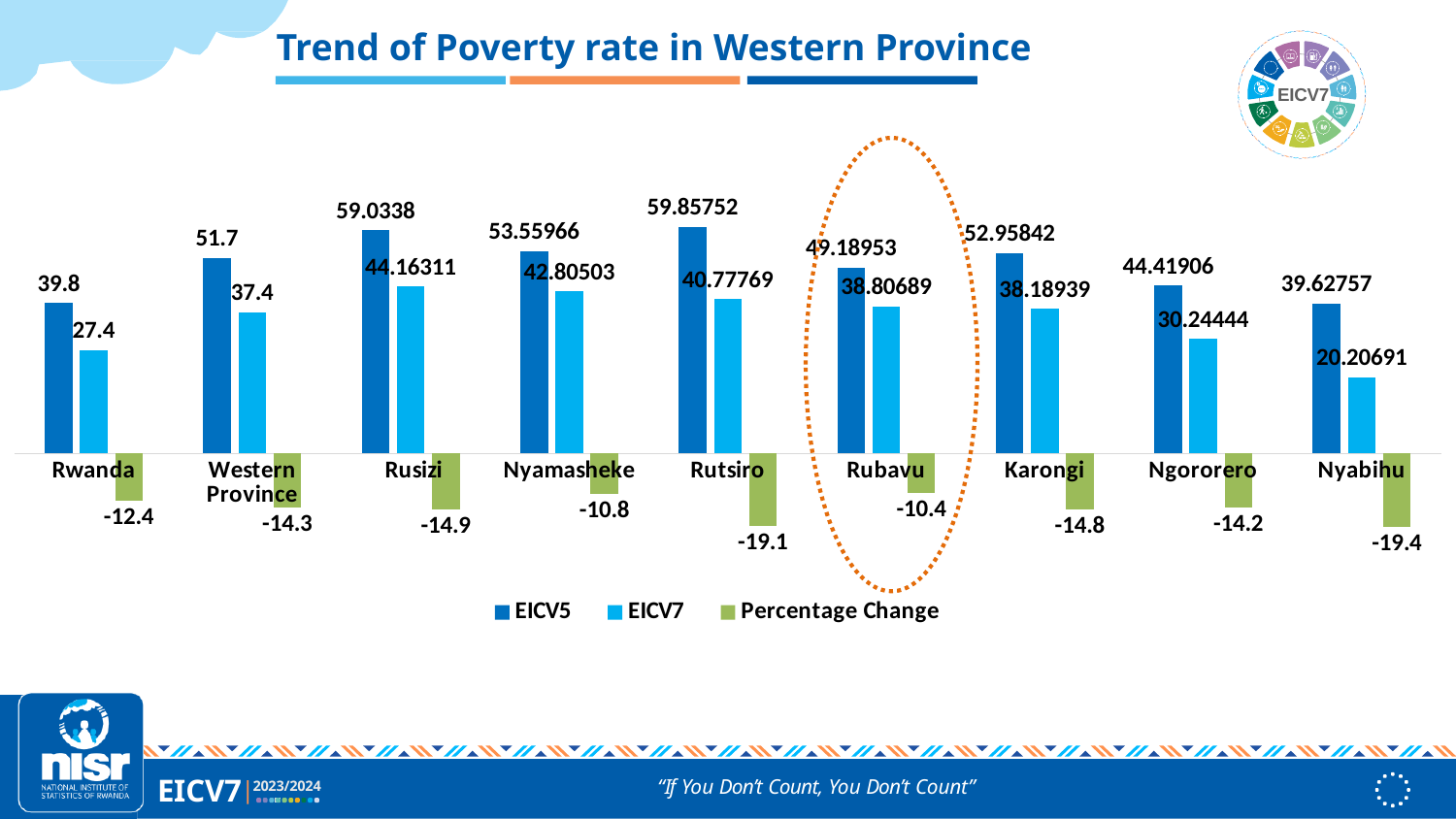
What is the EICV5 poverty rate for Nyabihu? 39.62757 Which is larger, the EICV7 poverty rate for Rusizi or for Nyamasheke? Rusizi Which category is highlighted with a dotted orange oval? Rubavu Which category has the highest EICV5 poverty rate? Rutsiro What is the EICV7 poverty rate for Rubavu? 38.80689 Which category has the lowest EICV7 poverty rate? Nyabihu Which category has the largest decrease (most negative Percentage Change)? Nyabihu What is the Percentage Change value for Rutsiro? -19.1 How many categories are shown on the x axis of the chart? 9 What kind of chart is shown on the slide? Bar chart What is the difference between the EICV5 and EICV7 poverty rates for Rwanda? 12.4 How many series does the legend list? 3